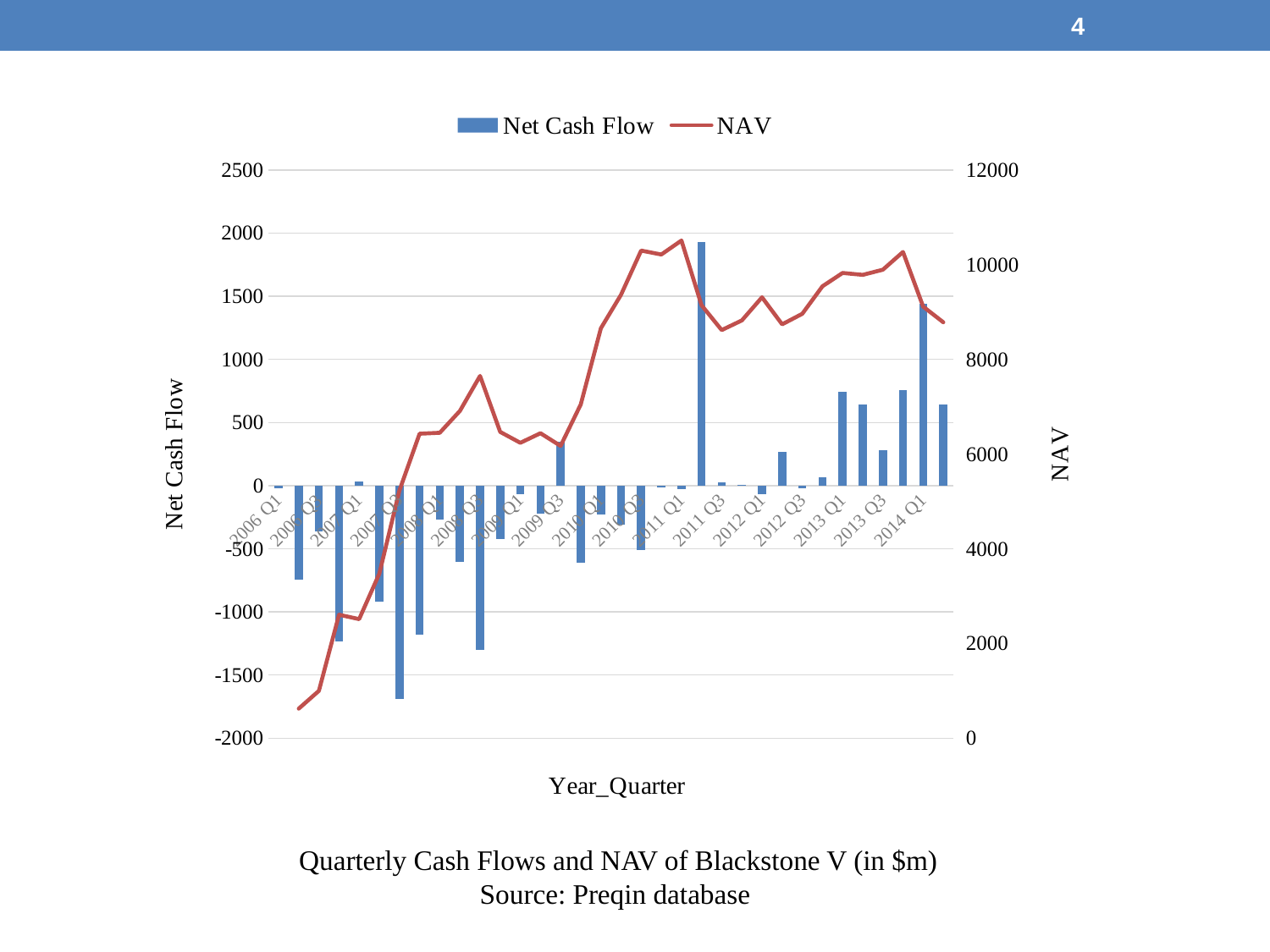
How many series does the legend list? 2 Is the highest Net Cash Flow bar greater or less than 1500? greater How many quarter labels are shown on the x axis? 17 Is the peak NAV value greater or less than 10000? greater Is the NAV value at the final point on the line greater or less than 10000? less Which series is drawn as bars and which as a line? Net Cash Flow is bars; NAV is a line Does the NAV line generally rise or fall from 2006 Q1 to 2014 Q1? rise What kind of chart is this? Combined bar and line chart What is the title of the x axis? Year_Quarter